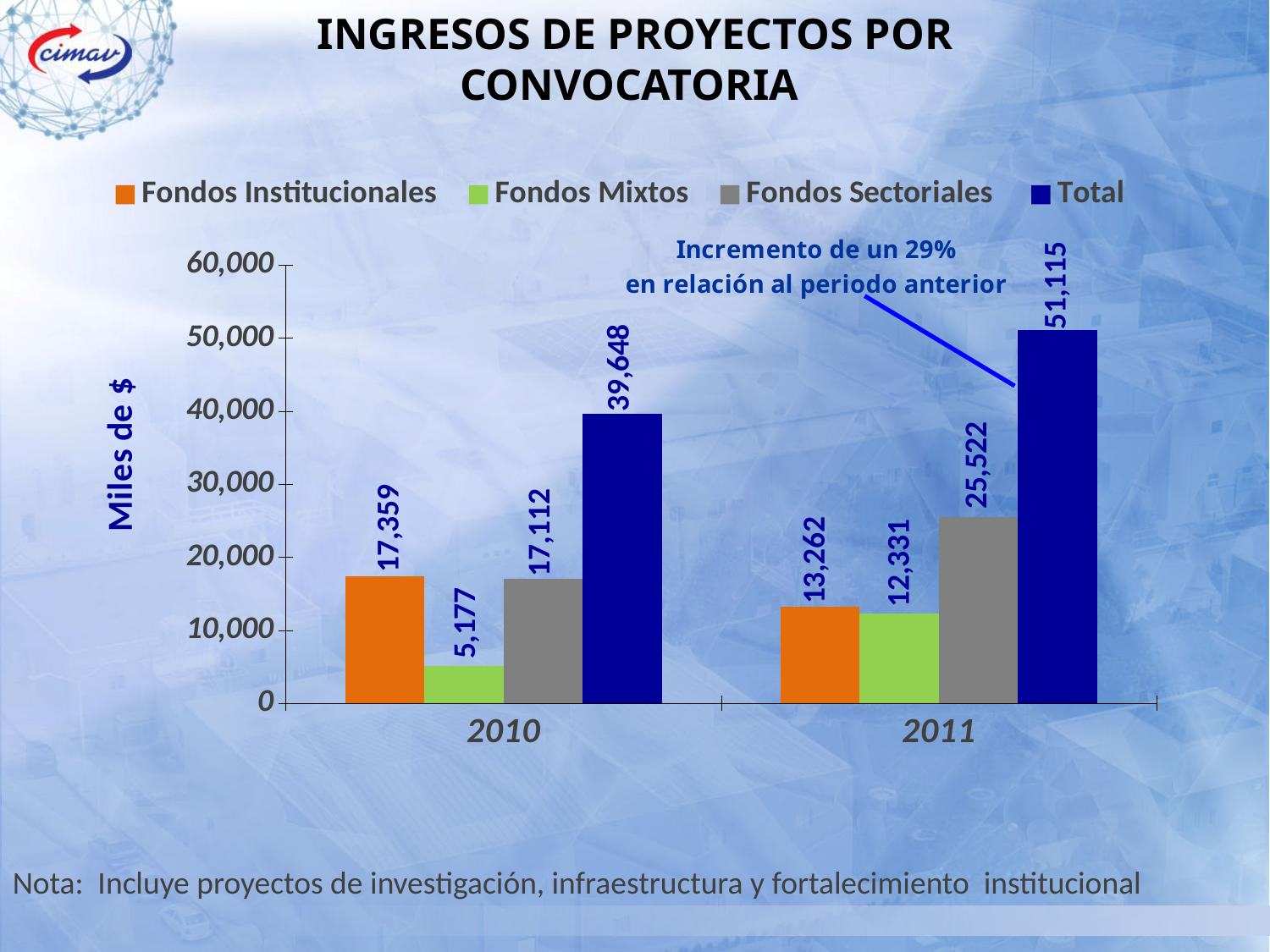
Which series has the lowest value in 2010? Fondos Mixtos How many years are shown on the x axis? 2 What is the difference between the Total for 2011 and the Total for 2010? 11,467 Which is larger: Fondos Institucionales in 2010 or Fondos Institucionales in 2011? Fondos Institucionales in 2010 What kind of chart is shown on the slide? Bar chart What is the Total value for 2011? 51,115 What is the value for Fondos Mixtos in 2011? 12,331 What is the y-axis label of the chart? Miles de $ Excluding Total, which series has the highest value in 2011? Fondos Sectoriales What is the value for Fondos Sectoriales in 2010? 17,112 How many series does the legend list? 4 What is the value for Fondos Institucionales in 2010? 17,359